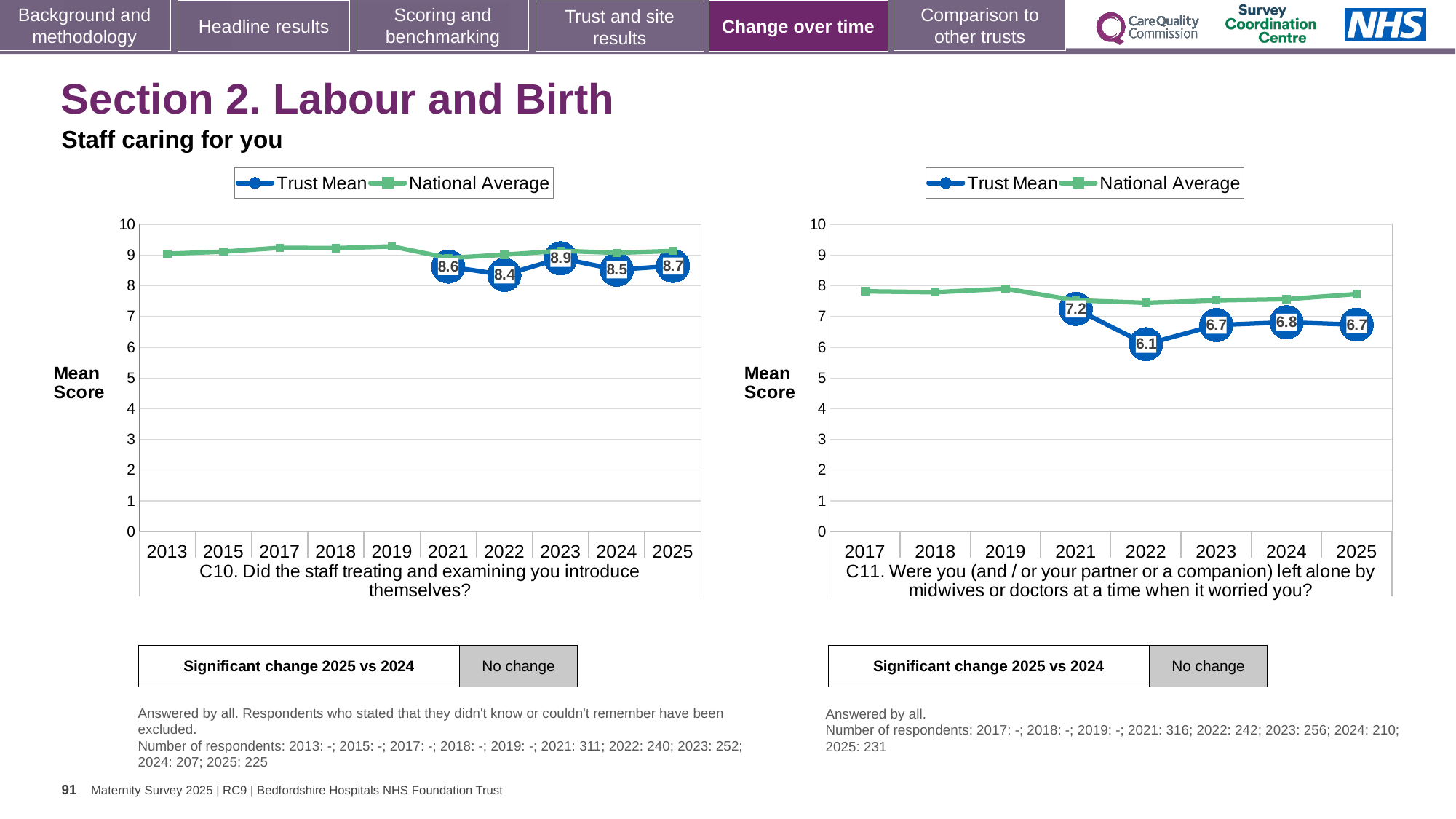
In the C11 chart (right), how many series does the legend list? 2 In the C11 chart (right), is the Trust Mean for 2021 or 2022 larger? 2021 What type of chart is the C10 chart on the left? Line chart In the C11 chart (right), which year has the highest Trust Mean value? 2021 In the C10 chart (left), how many years are shown on the x axis? 10 In the C11 chart (right), what is the Trust Mean value for 2022? 6.1 In the C11 chart (right), which year has the lowest Trust Mean value? 2022 In the C11 chart (right), is the National Average value for 2017 greater or less than 7? greater In the C10 chart (left), what is the difference between the Trust Mean values for 2023 and 2022? 0.5 In the C10 chart (left), which year has the highest Trust Mean value? 2023 In the C10 chart (left), what is the Trust Mean value for 2022? 8.4 In the C10 chart (left), what is the Trust Mean value for 2023? 8.9